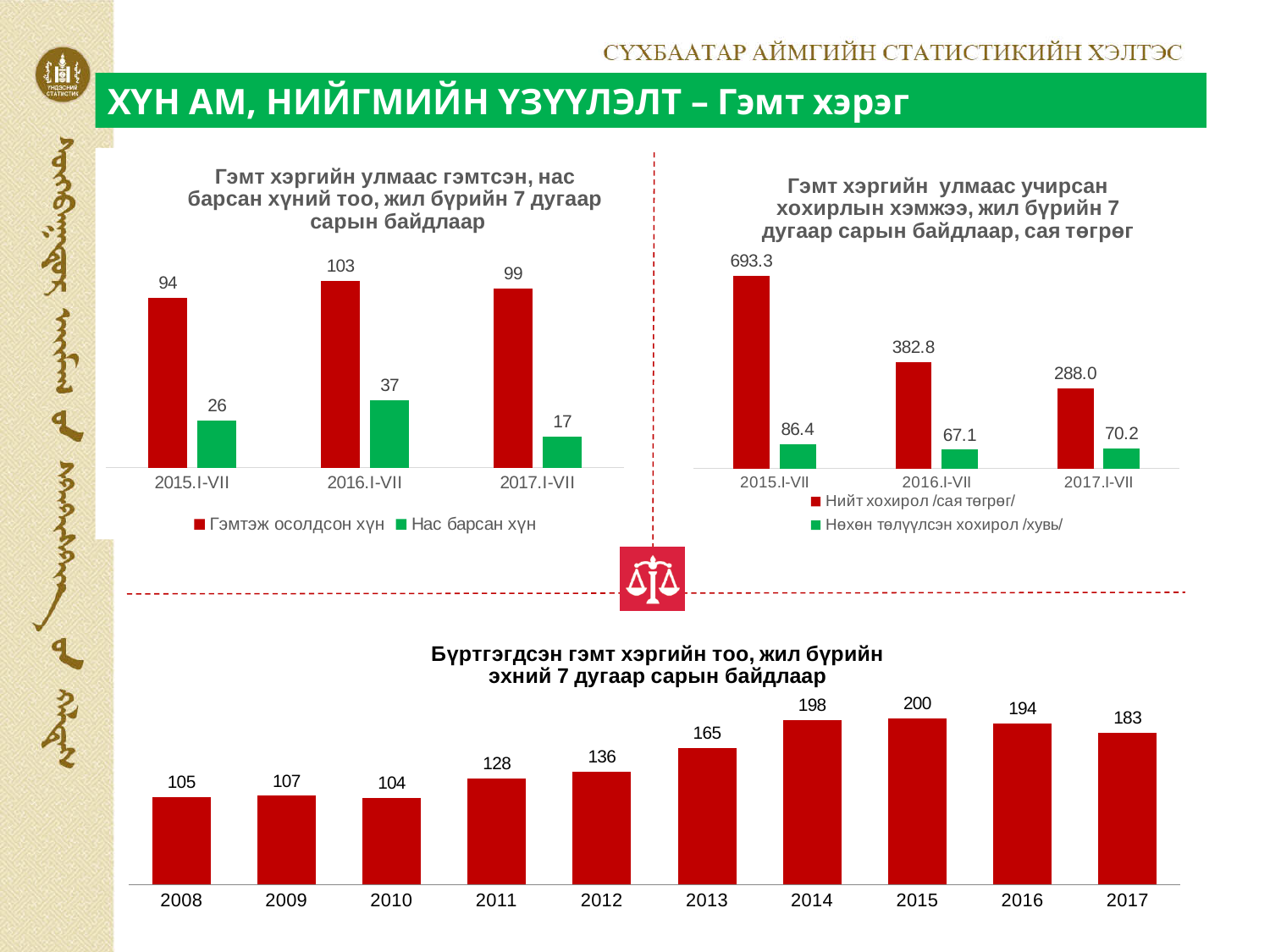
In the bottom chart (Бүртгэгдсэн гэмт хэргийн тоо), which year has the highest value? 2015 In the top-left chart (Гэмт хэргийн улмаас гэмтсэн, нас барсан хүний тоо), which period has the highest value for Гэмтэж осолдсон хүн? 2016.I-VII In the bottom chart (Бүртгэгдсэн гэмт хэргийн тоо), how many years are shown on the x axis? 10 In the top-right chart (Гэмт хэргийн улмаас учирсан хохирлын хэмжээ), what is the value for Нийт хохирол in 2015.I-VII? 693.3 In the top-right chart (Гэмт хэргийн улмаас учирсан хохирлын хэмжээ), what is the difference between Нийт хохирол in 2016.I-VII and 2017.I-VII? 94.8 What type of chart is the bottom chart (Бүртгэгдсэн гэмт хэргийн тоо)? Bar chart In the top-right chart (Гэмт хэргийн улмаас учирсан хохирлын хэмжээ), which is larger: Нөхөн төлүүлсэн хохирол in 2015.I-VII or in 2016.I-VII? 2015.I-VII In the bottom chart (Бүртгэгдсэн гэмт хэргийн тоо), what is the value for 2014? 198 In the bottom chart (Бүртгэгдсэн гэмт хэргийн тоо), what is the difference between the values for 2017 and 2008? 78 In the top-left chart (Гэмт хэргийн улмаас гэмтсэн, нас барсан хүний тоо), how many series does the legend list? 2 In the bottom chart (Бүртгэгдсэн гэмт хэргийн тоо), which year has the lowest value? 2010 In the top-left chart (Гэмт хэргийн улмаас гэмтсэн, нас барсан хүний тоо), what is the value for Нас барсан хүн in 2016.I-VII? 37